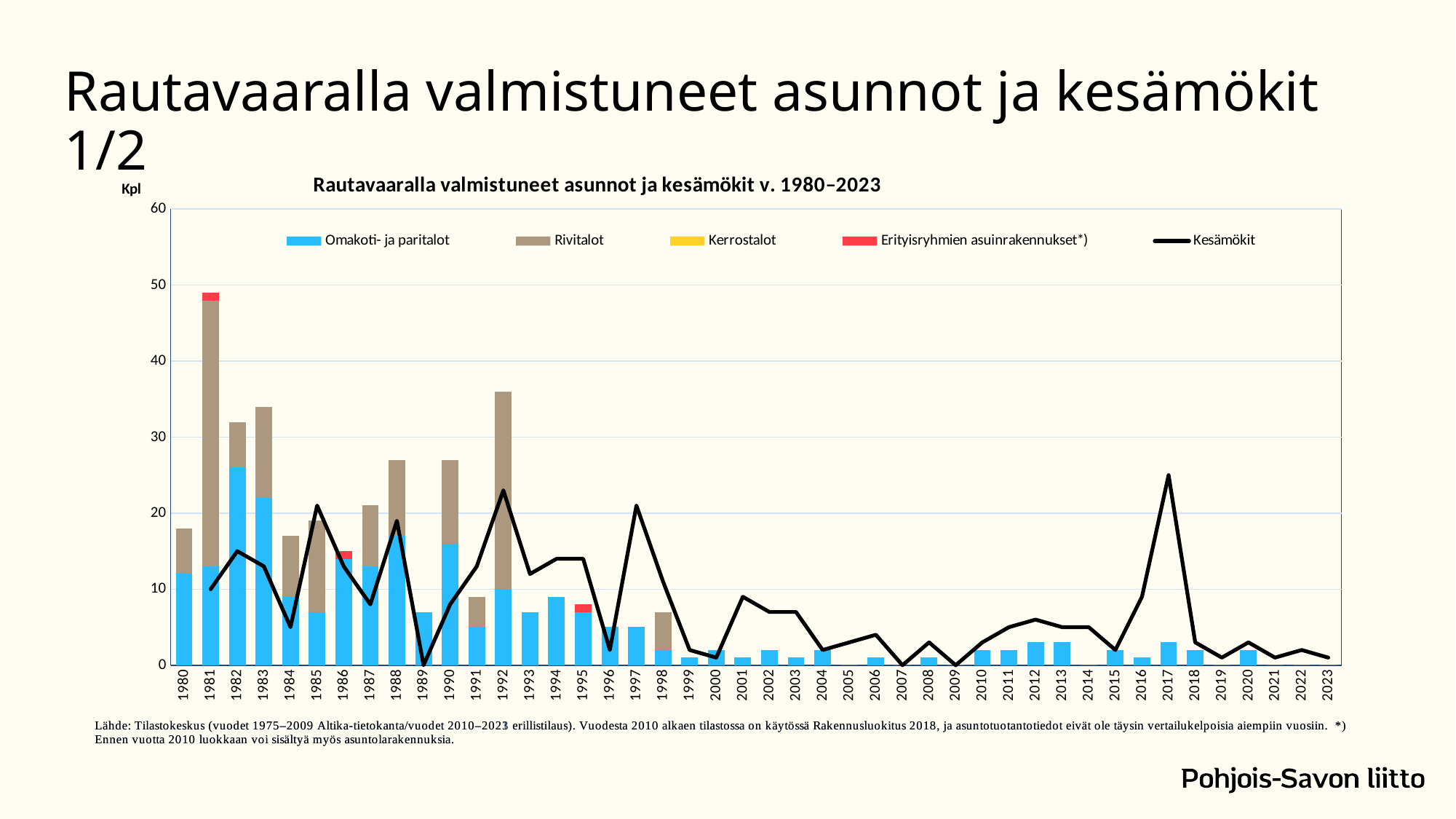
What kind of chart is this? Stacked bar chart with a line How many series does the legend list? 5 How many years are shown on the x axis? 44 Is the total stacked bar for 1981 greater or less than 40? greater Does the Kesämökit line rise or fall from 2017 to 2018? fall Is the total stacked bar for 1992 greater or less than 30? greater Which series is drawn as a black line? Kesämökit Which year has the highest total stacked bar? 1981 Is the total stacked bar for 1988 greater or less than 30? less Which has the larger total stacked bar, 1990 or 1992? 1992 What is the title of the chart? Rautavaaralla valmistuneet asunnot ja kesämökit v. 1980–2023